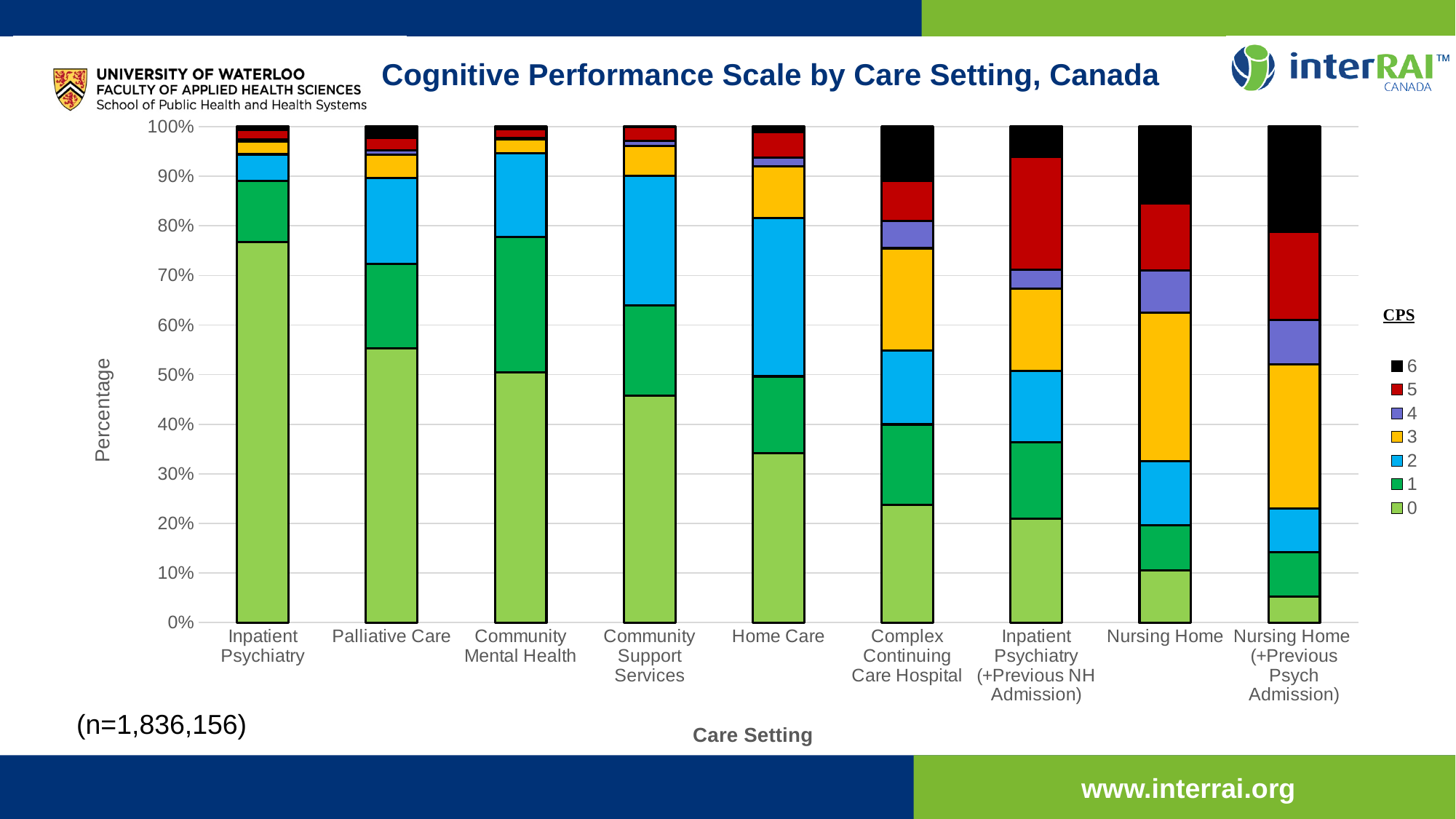
Which care setting has the largest share of CPS 0? Inpatient Psychiatry Is the share of CPS 0 for Home Care greater or less than 30%? greater Is the share of CPS 0 for Inpatient Psychiatry greater or less than 70%? greater Is the share of CPS 0 for Nursing Home (+Previous Psych Admission) greater or less than 10%? less How many CPS levels does the legend list? 7 What is the title of the chart? Cognitive Performance Scale by Care Setting, Canada What kind of chart is shown on the slide? Stacked bar chart What is the label on the y axis? Percentage Which has a larger share of CPS 0, Community Support Services or Home Care? Community Support Services Which care setting has the largest share of CPS 6? Nursing Home (+Previous Psych Admission) How many care settings are shown along the x axis? 9 Which care setting has the smallest share of CPS 0? Nursing Home (+Previous Psych Admission)